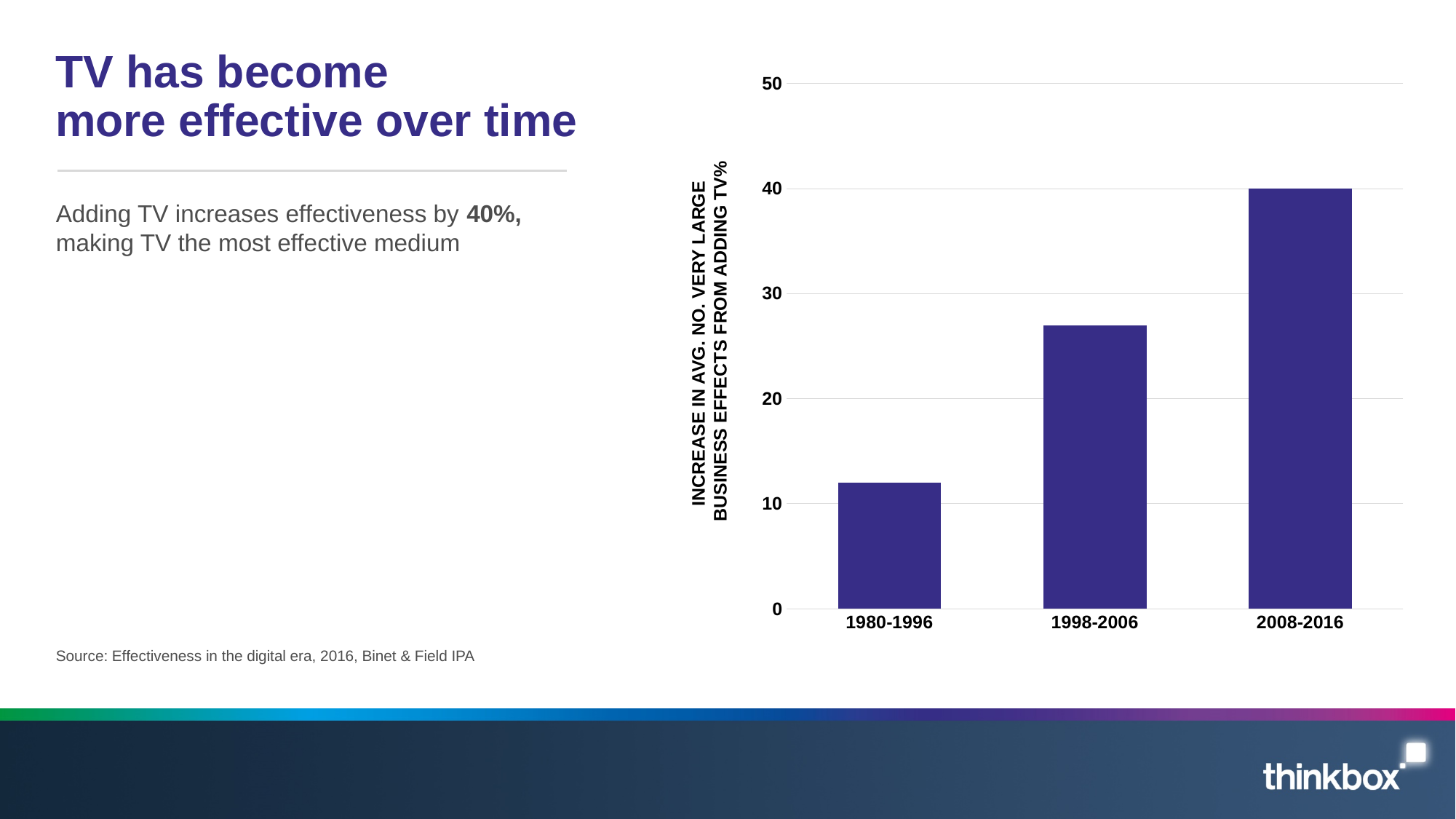
What kind of chart is shown on the slide? bar chart Which period has the highest bar? 2008-2016 Do the values rise or fall from 1980-1996 to 2008-2016? rise What is the value for 2008-2016? 40 Is the value for 1980-1996 greater or less than 20? less Is the value for 1998-2006 greater or less than 20? greater What is the highest value shown on the y axis? 50 Which is larger, the value for 1998-2006 or the value for 1980-1996? 1998-2006 Is the value for 1998-2006 greater or less than 30? less Which period has the lowest bar? 1980-1996 How many time periods are plotted on the x axis? 3